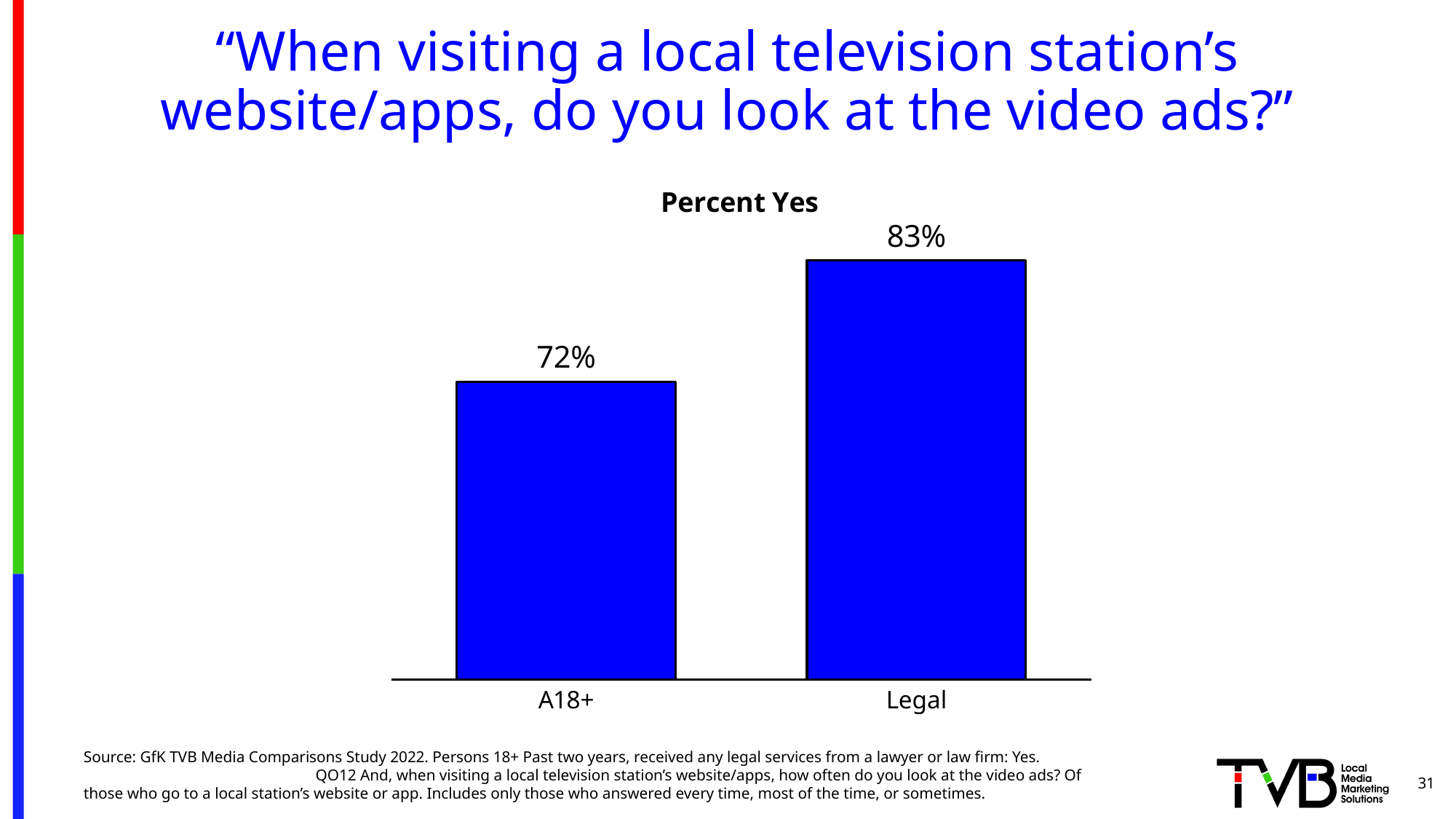
What is the title of the chart? Percent Yes Do the values rise or fall from A18+ to Legal? Rise Which category has the lowest Percent Yes value? A18+ What kind of chart is shown on the slide? Bar chart How many categories are shown in the chart? 2 Which category has the highest Percent Yes value? Legal What colour are the bars in the chart? Blue What is the difference in Percent Yes between Legal and A18+? 11% What is the Percent Yes value for Legal? 83% Which is larger, the Percent Yes for A18+ or for Legal? Legal What is the Percent Yes value for A18+? 72%